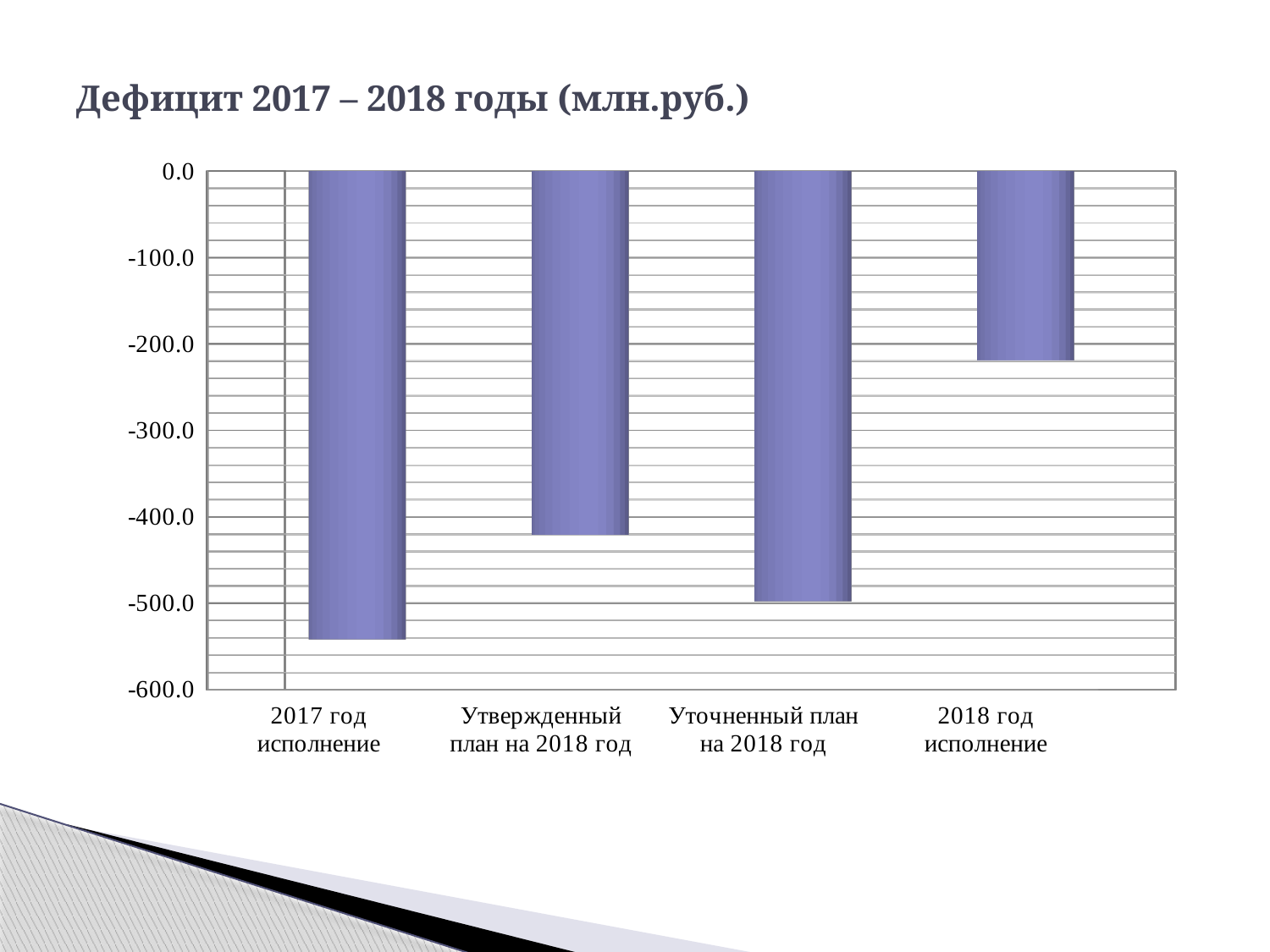
Which is larger, the value for "Утвержденный план на 2018 год" or the value for "Уточненный план на 2018 год"? Утвержденный план на 2018 год What is the lowest value shown on the vertical axis? -600.0 Is the value for "2018 год исполнение" greater or less than -300.0? greater Is the value for "2018 год исполнение" greater or less than -200.0? less How many categories (bars) are plotted in the chart? 4 Which category has the lowest (most negative) value in the chart? 2017 год исполнение Is the value for "Утвержденный план на 2018 год" greater or less than -400.0? less Which category has the highest value (closest to zero) in the chart? 2018 год исполнение What is the title of the chart? Дефицит 2017 – 2018 годы (млн.руб.) What kind of chart is shown on the slide? bar chart Which is larger, the value for "2017 год исполнение" or the value for "2018 год исполнение"? 2018 год исполнение